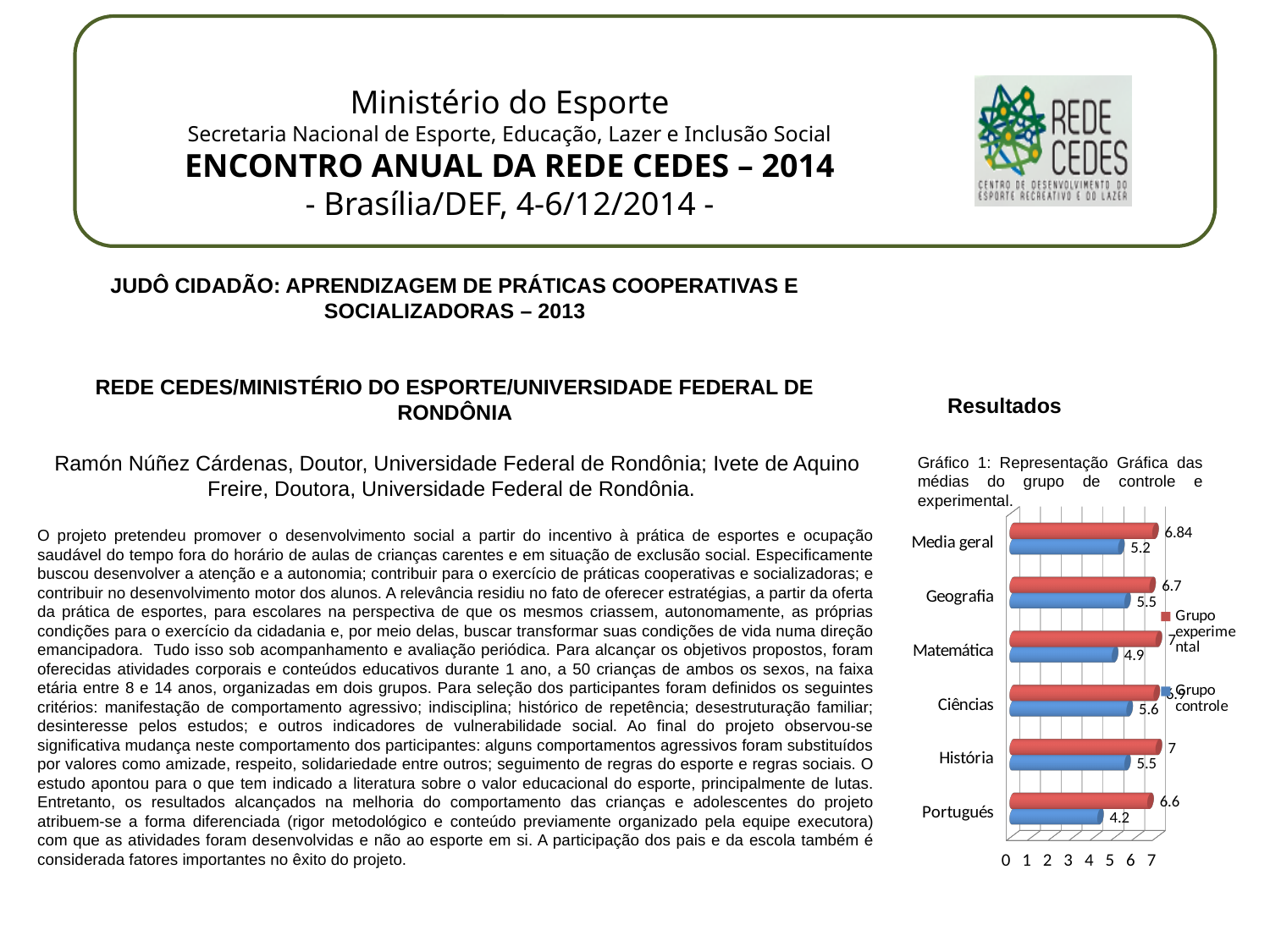
Which category has the lowest value for Grupo controle? Portugués What is the value for Grupo experimental in História? 7 What is the difference between Grupo experimental and Grupo controle in Media geral? 1.64 How many series does the legend list? 2 What is the value for Grupo controle in Portugués? 4.2 How many categories are shown on the chart? 6 Which category has the highest value for Grupo controle? Ciências What is the value for Grupo experimental in Media geral? 6.84 What kind of chart is shown on the slide? Bar chart Which is larger in Matemática, Grupo experimental or Grupo controle? Grupo experimental What is the value for Grupo controle in Geografia? 5.5 Is the value for Grupo controle in Matemática greater or less than 5? less